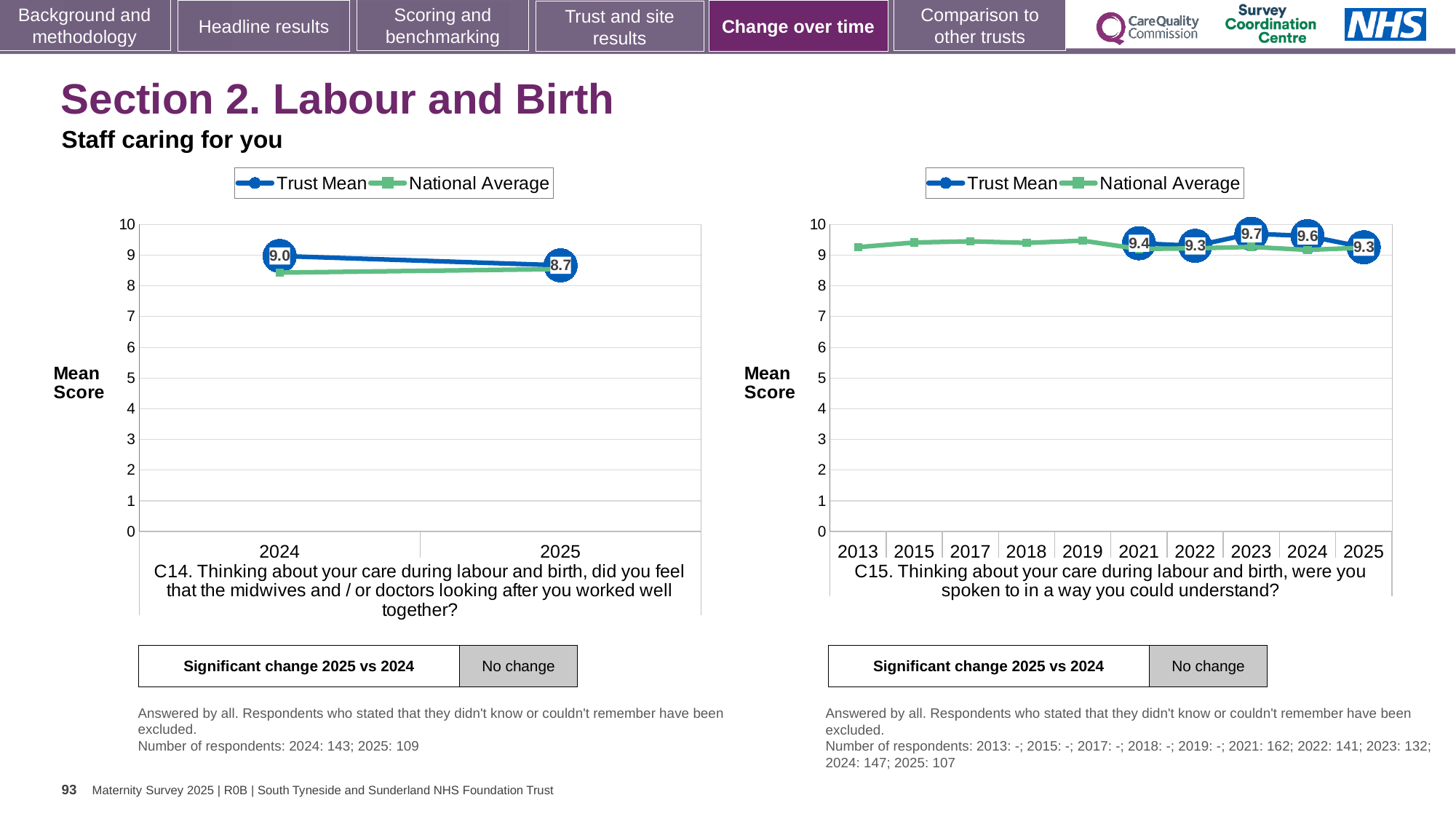
In the C14 chart on the left, by how much did the Trust Mean change from 2024 to 2025? 0.3 In the C15 chart on the right, what is the Trust Mean for 2025? 9.3 In the C15 chart on the right, which year has the highest Trust Mean? 2023 In the C14 chart on the left, is the National Average for 2024 greater or less than 9? less In the C15 chart on the right, what is the Trust Mean for 2023? 9.7 In the C15 chart on the right, how many years are shown on the x axis? 10 In the C14 chart on the left, what is the Trust Mean for 2024? 9.0 In the C15 chart on the right, what is the difference between the Trust Mean in 2023 and in 2025? 0.4 In the C14 chart on the left, does the Trust Mean rise or fall from 2024 to 2025? fall How many series does the legend of the C15 chart on the right list? 2 In the C14 chart on the left, what is the Trust Mean for 2025? 8.7 What type of chart is the C14 chart on the left? line chart